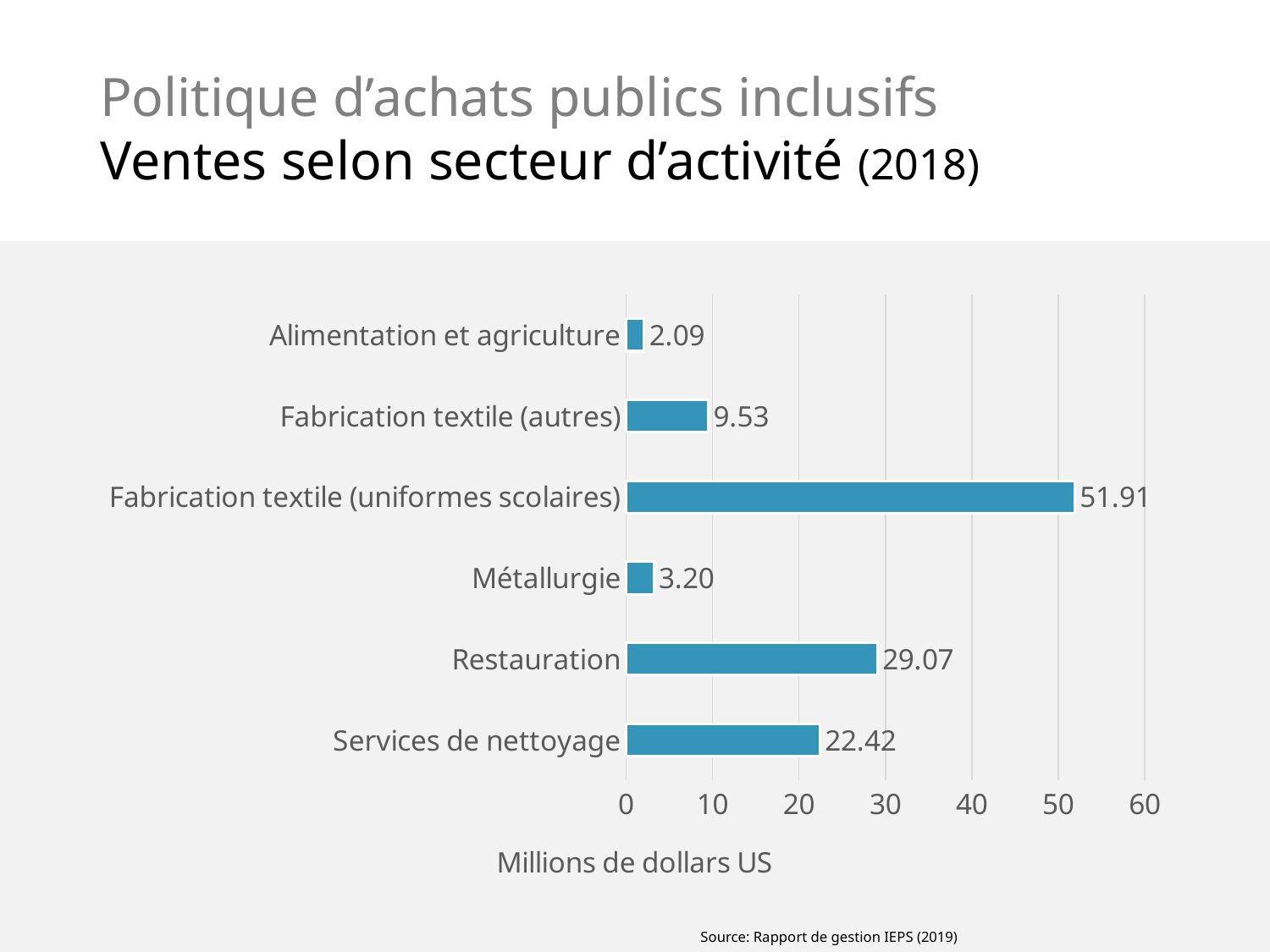
Which is larger, Fabrication textile (autres) or Métallurgie? Fabrication textile (autres) How many sectors are shown in the chart? 6 What is the value for Fabrication textile (uniformes scolaires)? 51.91 What is the difference between Restauration and Services de nettoyage? 6.65 What is the value for Services de nettoyage? 22.42 Is the value for Fabrication textile (uniformes scolaires) greater or less than 50? greater Which sector has the highest value? Fabrication textile (uniformes scolaires) Which sector has the lowest value? Alimentation et agriculture What kind of chart is shown on the slide? Bar chart What is the value for Métallurgie? 3.20 What is the value for Restauration? 29.07 What unit is shown on the x axis label? Millions de dollars US